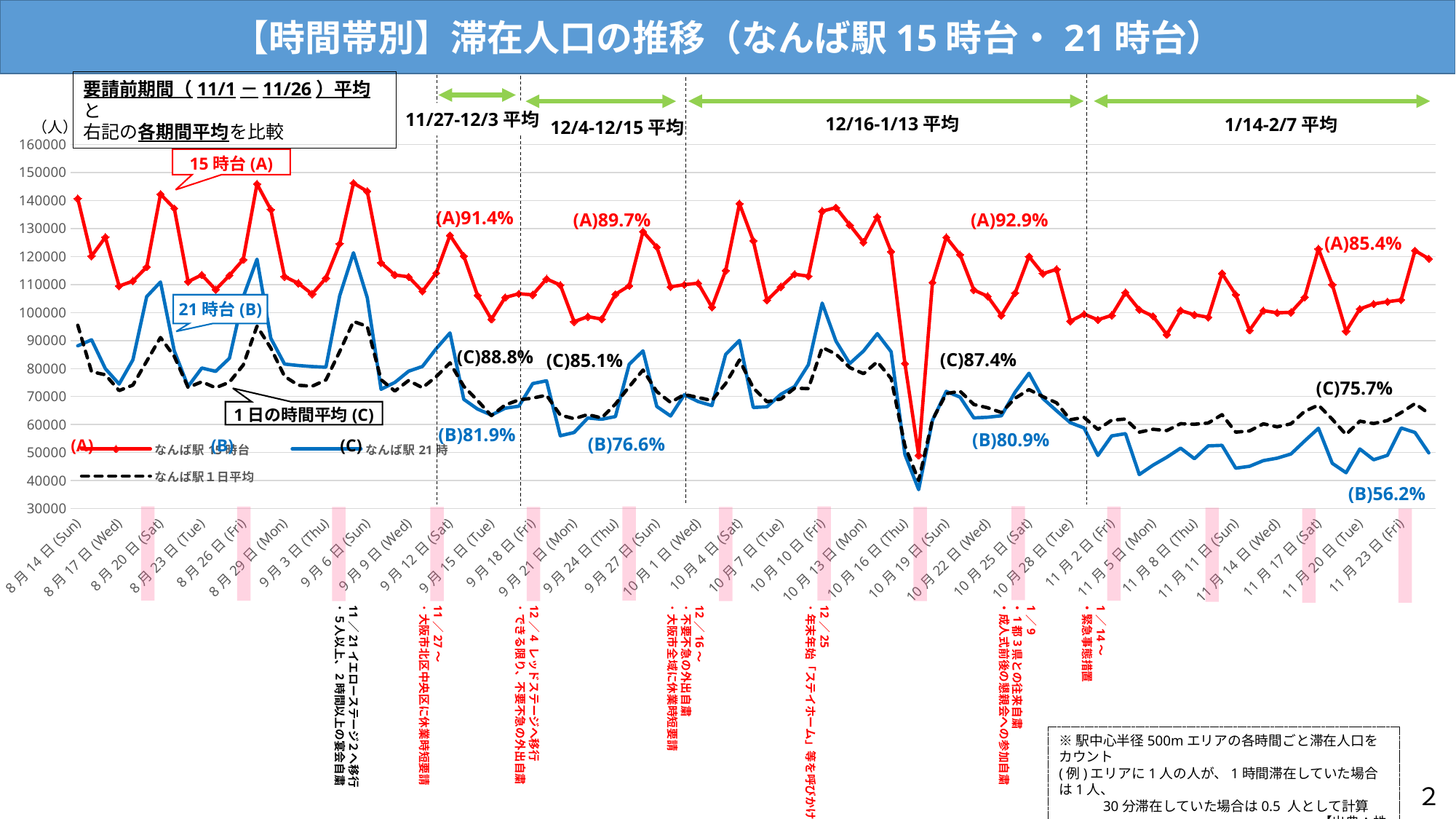
What percentage is shown for (A) in the 12/4-12/15 平均 period? 89.7% What percentage is shown for (A) in the 11/27-12/3 平均 period? 91.4% Is the value of なんば駅15時台 on 8月14日(Sun) greater or less than 130000? greater In the 11/27-12/3 平均 period, what is the difference between the (A) percentage and the (B) percentage? 9.5 percentage points What percentage is shown for (C) in the 12/16-1/13 平均 period? 87.4% Which series is drawn as a black dashed line? なんば駅1日平均 (C) What kind of chart is shown on the slide? line chart In the 12/16-1/13 平均 period, which is larger: the (A) percentage or the (C) percentage? (A) Which series has the highest values across the chart? なんば駅15時台 (A) What percentage is shown for (B) in the 1/14-2/7 平均 period? 56.2% How many series does the chart's legend list? 3 Among the four (B) percentages shown, which period has the lowest value? 1/14-2/7 平均 (56.2%)